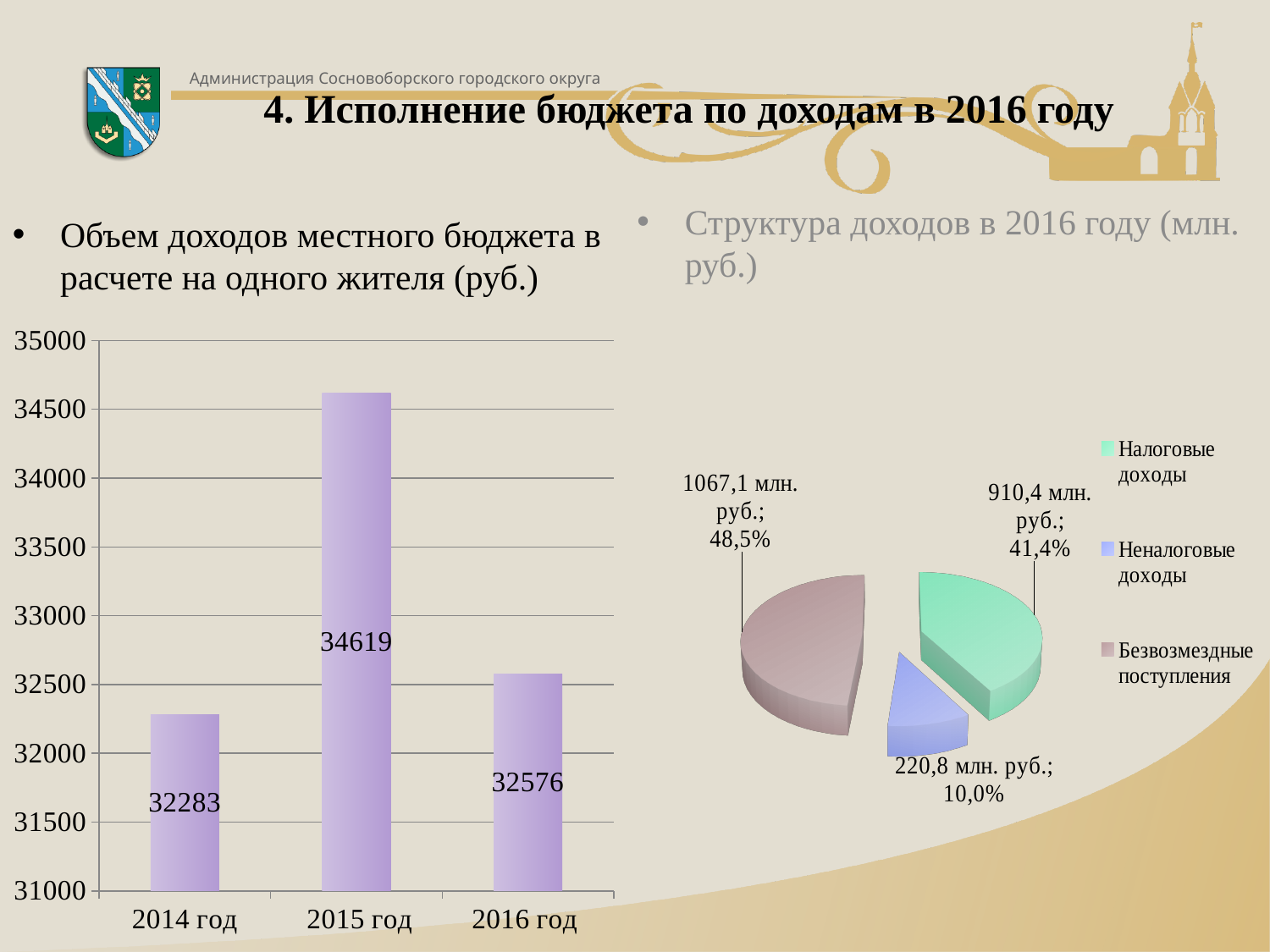
In the left bar chart, what is the value for 2014 год? 32283 In the left bar chart, how many years are shown? 3 In the left bar chart, which is larger: the value for 2016 год or 2014 год? 2016 год In the left bar chart (Объем доходов местного бюджета в расчете на одного жителя), what is the value for 2015 год? 34619 How many entries does the legend of the right pie chart list? 3 In the right pie chart, which category has the largest slice? Безвозмездные поступления In the right pie chart (Структура доходов в 2016 году), what share does Безвозмездные поступления have? 48,5% In the left bar chart, which year has the highest value? 2015 год In the right pie chart, what is the value for Неналоговые доходы? 220,8 млн. руб. What type of chart is the left chart on the slide? Bar chart In the left bar chart, what is the difference between the values for 2015 год and 2016 год? 2043 In the left bar chart, which year has the lowest value? 2014 год